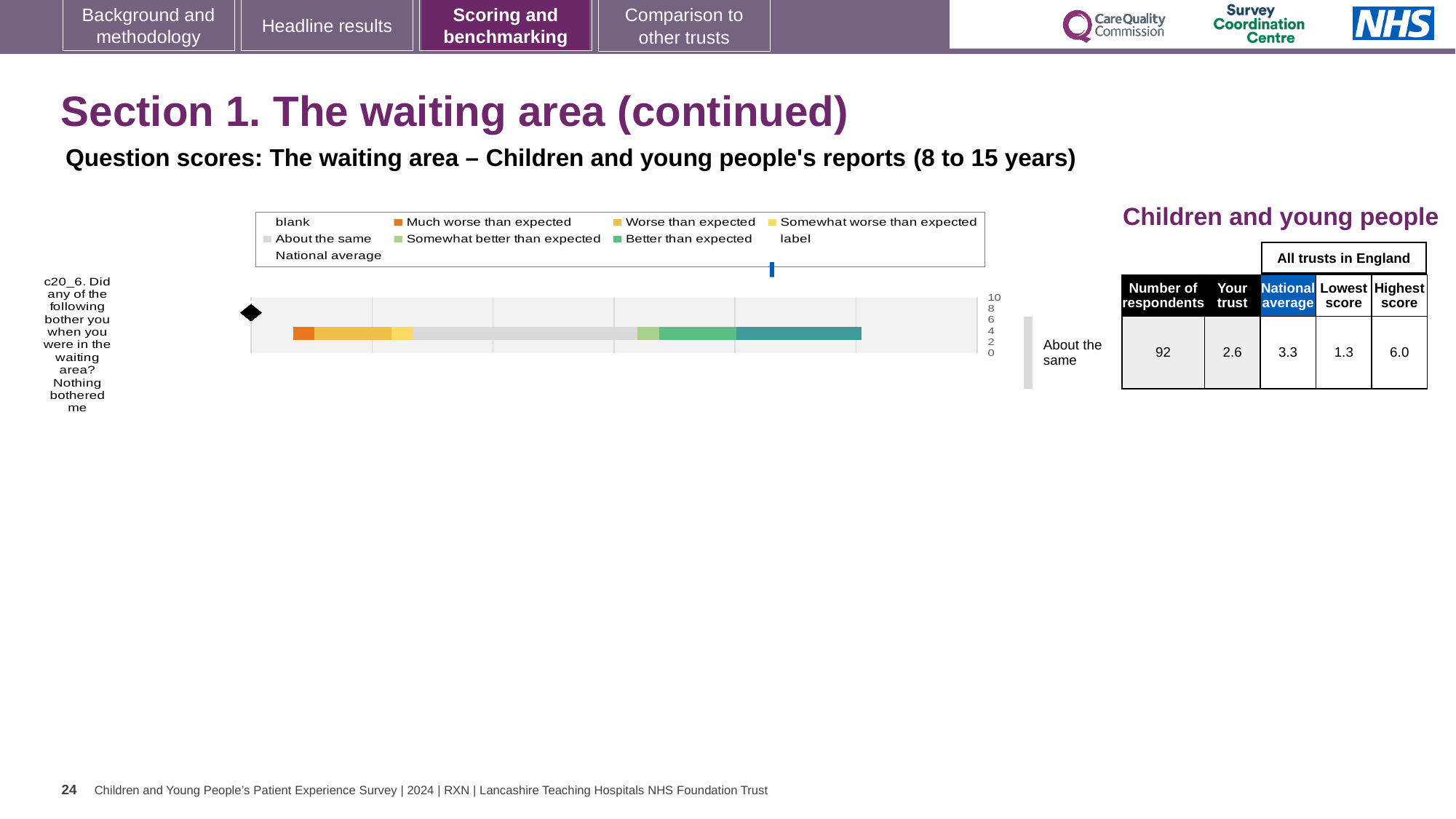
Which legend entry is shown in dark orange? Much worse than expected What category label is shown to the right of the bar for question c20_6? About the same What kind of chart is shown on the slide for question c20_6? bar chart What is the national average score for question c20_6? 3.3 How many respondents answered question c20_6? 92 What is the 'Your trust' score for question c20_6 in the table next to the chart? 2.6 What is the difference between the highest score and the lowest score for question c20_6? 4.7 By how much does the national average exceed the 'Your trust' score for question c20_6? 0.7 What is the lowest score among all trusts in England for question c20_6? 1.3 What is the highest score among all trusts in England for question c20_6? 6.0 Which is larger for question c20_6: the 'Your trust' score or the national average? National average How many questions (categories) are plotted in the chart? 1